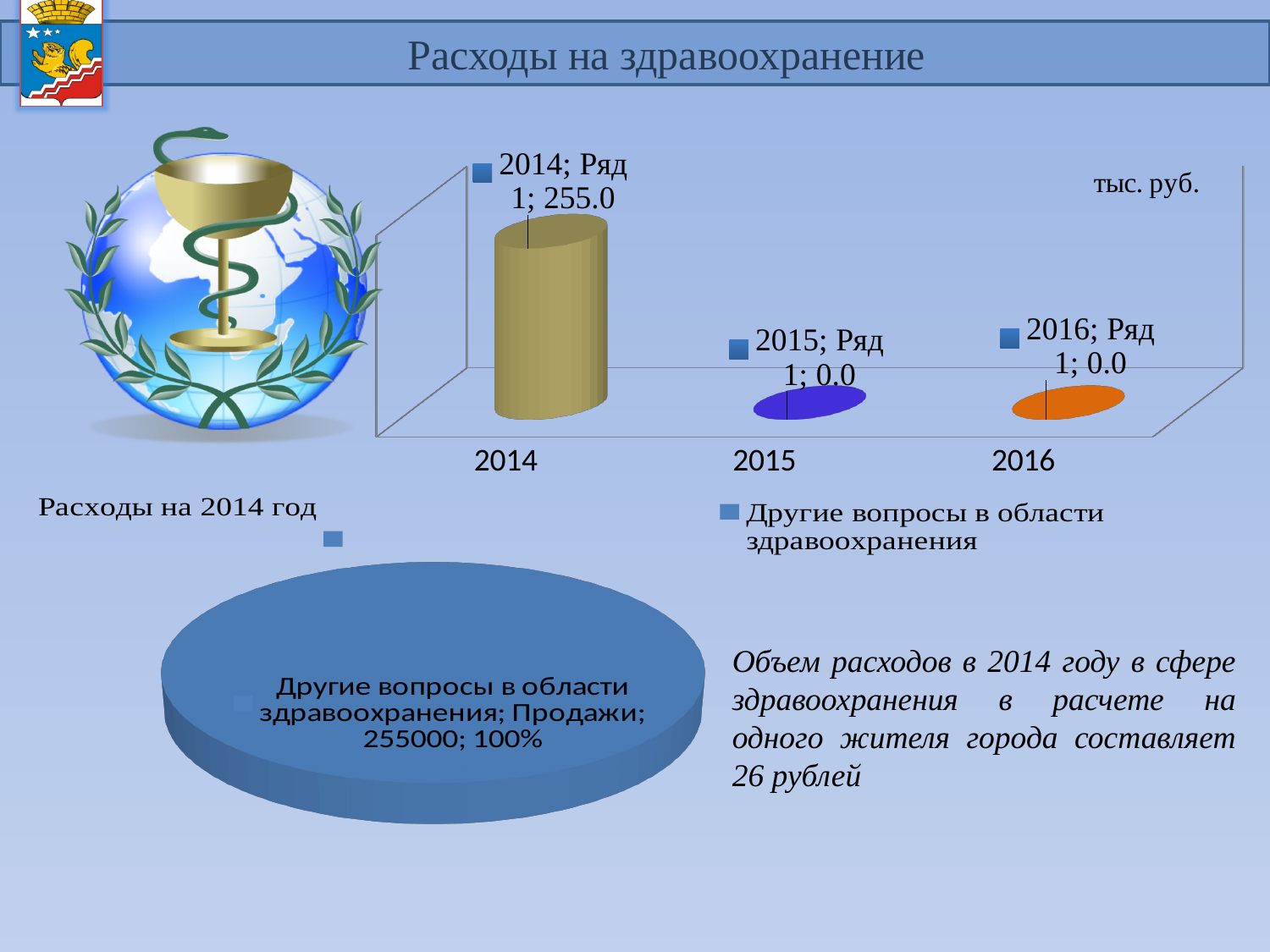
In the top chart, which year has the highest value? 2014 In the top chart, what is the difference between the values for 2014 and 2015? 255.0 In the pie chart 'Расходы на 2014 год', what share does 'Другие вопросы в области здравоохранения' have? 100% In the top chart, what is the value for 2015? 0.0 In the top chart, what is the value for 2014? 255.0 In the pie chart 'Расходы на 2014 год', what is the value for 'Другие вопросы в области здравоохранения'? 255000 What kind of chart is the top chart? bar chart How many years are shown on the x axis of the top chart? 3 In the top chart, do the values rise or fall from 2014 to 2016? fall What unit is shown for the top chart? тыс. руб. In the top chart, which is larger, the value for 2014 or the value for 2016? 2014 In the top chart, what is the value for 2016? 0.0